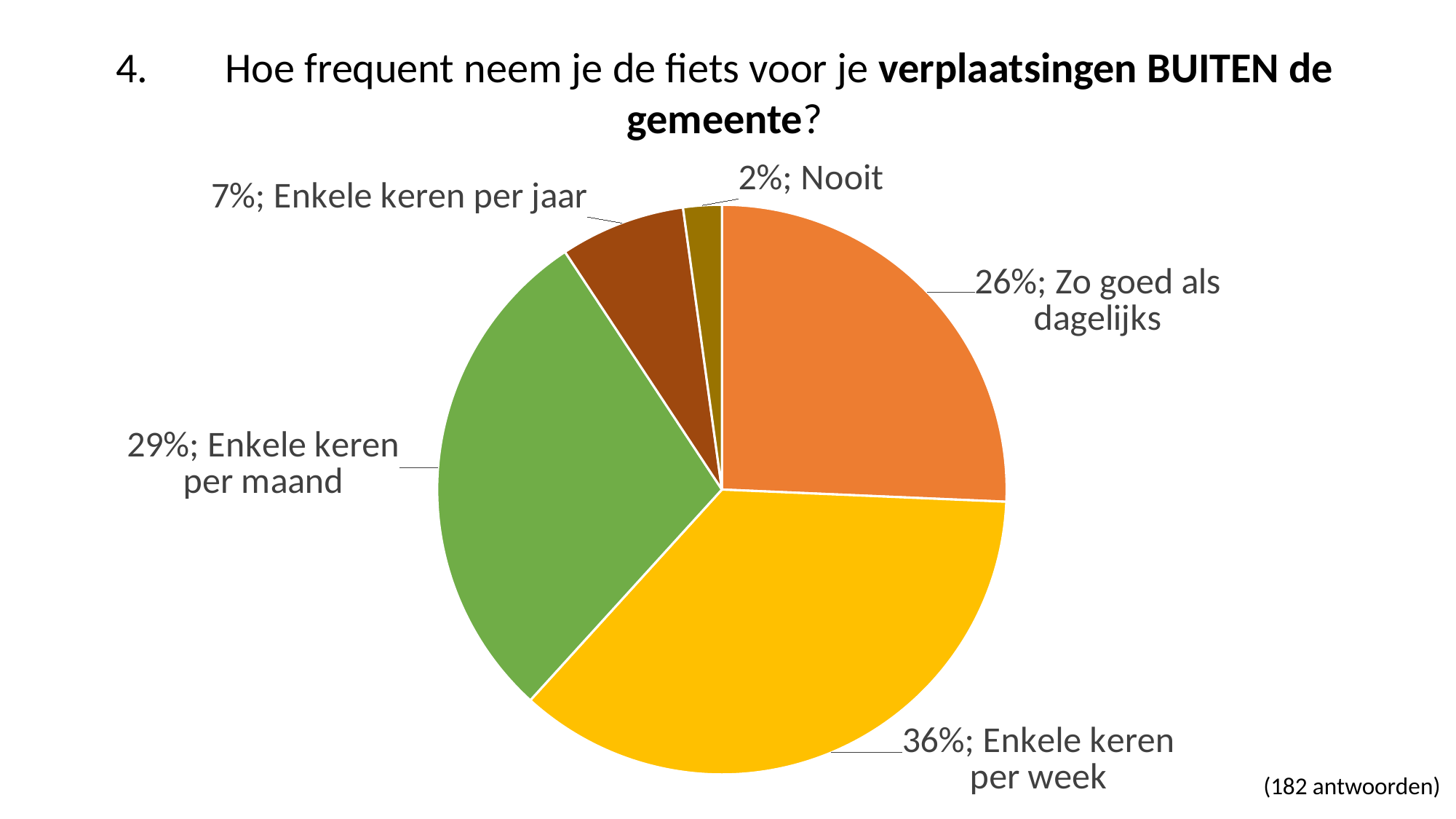
Which category has the largest slice of the pie? Enkele keren per week What share of the pie is 'Enkele keren per week'? 36% Which category has the smallest slice of the pie? Nooit Which is larger: 'Enkele keren per maand' or 'Zo goed als dagelijks'? Enkele keren per maand What is the difference in percentage points between 'Enkele keren per week' and 'Zo goed als dagelijks'? 10 What share of the pie is 'Enkele keren per maand'? 29% What share of the pie is 'Zo goed als dagelijks'? 26% What kind of chart is shown on the slide? pie chart How many responses does the slide say the chart is based on? 182 antwoorden How many slices does the pie chart have? 5